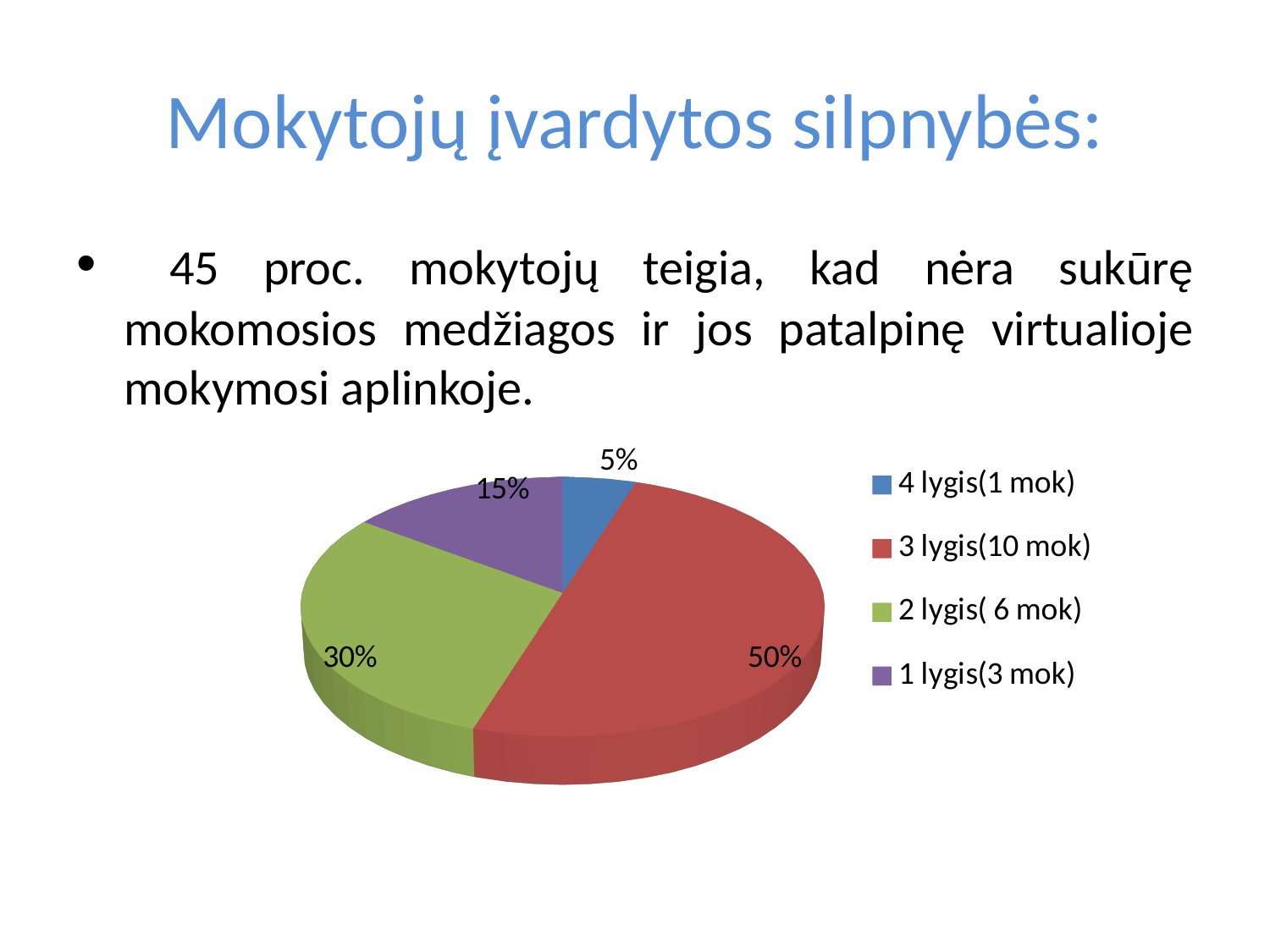
What share of the pie does "1 lygis(3 mok)" have? 15% What share of the pie does "3 lygis(10 mok)" have? 50% Which slice is larger: "1 lygis(3 mok)" or "2 lygis( 6 mok)"? 2 lygis( 6 mok) What is the difference in percentage points between the "3 lygis(10 mok)" slice and the "2 lygis( 6 mok)" slice? 20 percentage points What share of the pie does "4 lygis(1 mok)" have? 5% Which legend entry is shown in green? 2 lygis( 6 mok) Which category has the largest slice of the pie? 3 lygis(10 mok) How many slices does the pie chart have? 4 Which category has the smallest slice of the pie? 4 lygis(1 mok) What kind of chart is shown on the slide? pie chart What colour is the "3 lygis(10 mok)" slice? red